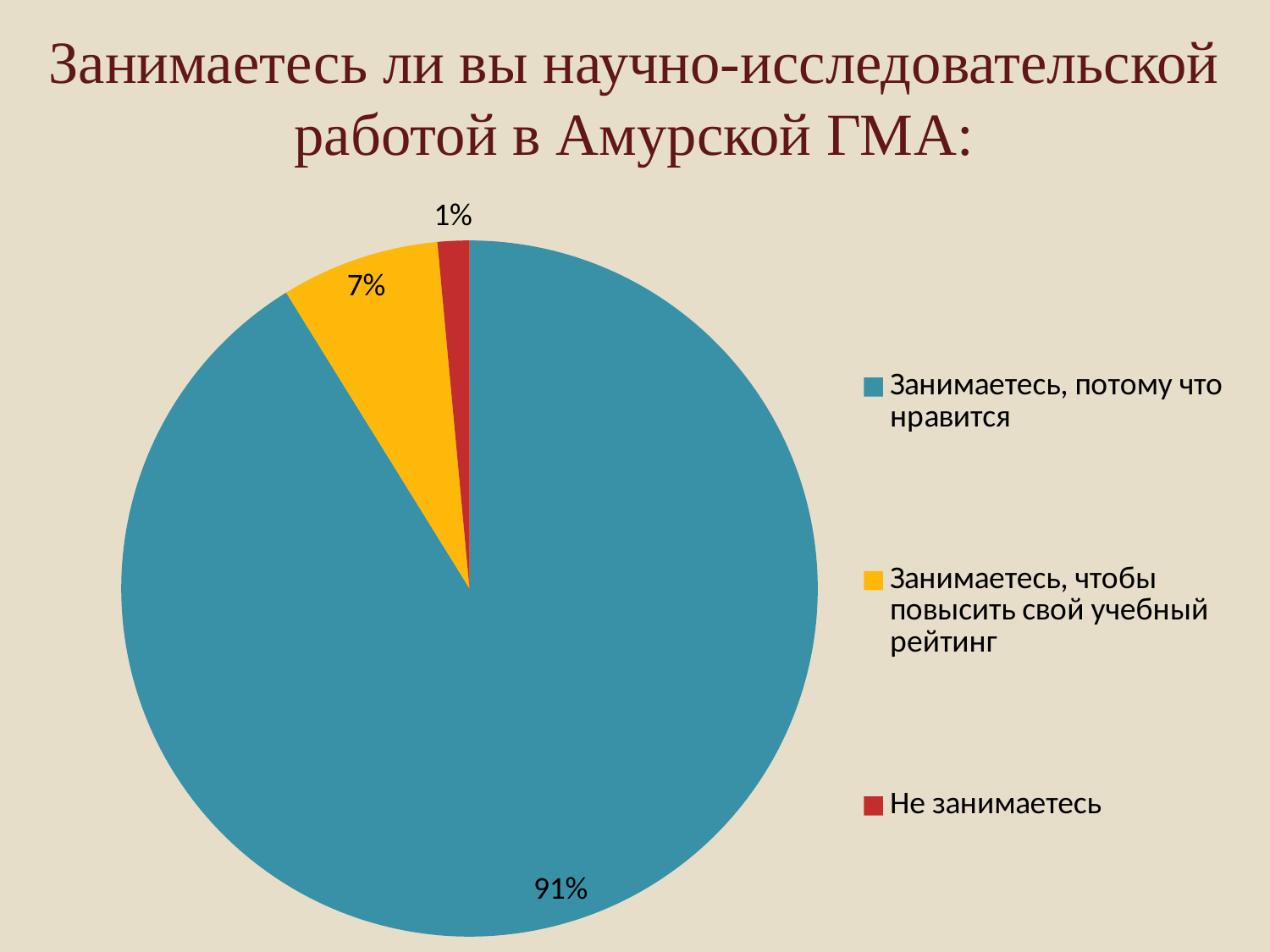
What kind of chart is shown on the slide? pie chart What is the difference in percentage points between "Занимаетесь, чтобы повысить свой учебный рейтинг" and "Не занимаетесь"? 6 Which is larger: the share for "Занимаетесь, чтобы повысить свой учебный рейтинг" or for "Не занимаетесь"? Занимаетесь, чтобы повысить свой учебный рейтинг What is the title of the slide? Занимаетесь ли вы научно-исследовательской работой в Амурской ГМА: Which category has the largest slice of the pie? Занимаетесь, потому что нравится What share of respondents answered "Занимаетесь, потому что нравится"? 91% What share of respondents answered "Не занимаетесь"? 1% Which category has the smallest slice of the pie? Не занимаетесь What share of respondents answered "Занимаетесь, чтобы повысить свой учебный рейтинг"? 7% What colour is the slice for "Не занимаетесь"? red What is the difference in percentage points between "Занимаетесь, потому что нравится" and "Занимаетесь, чтобы повысить свой учебный рейтинг"? 84 How many categories does the pie chart show? 3